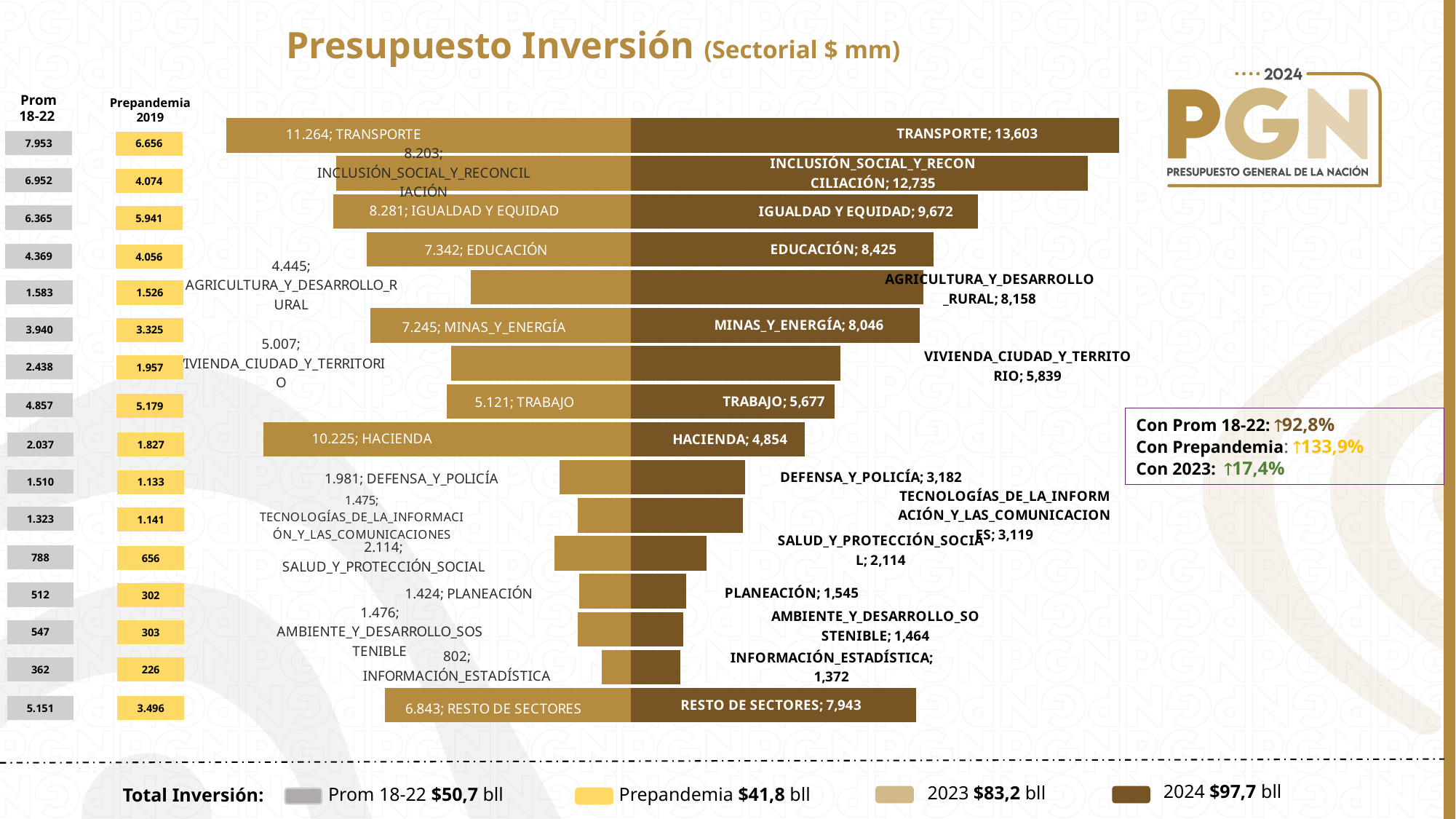
What is the title of the chart? Presupuesto Inversión (Sectorial $ mm) What is the difference between the 2024 and 2023 values for TRANSPORTE? 2,339 Which sector has the highest 2024 value? TRANSPORTE What is the 2024 value for INFORMACIÓN_ESTADÍSTICA? 1,372 What kind of chart is shown on the slide? bar chart In 2024, which is larger: EDUCACIÓN or MINAS_Y_ENERGÍA? EDUCACIÓN Which sector has the lowest 2023 value? INFORMACIÓN_ESTADÍSTICA How many sectors are plotted as bars in the chart? 16 For HACIENDA, which is larger: the 2023 value or the 2024 value? 2023 What is the difference between the 2023 and 2024 values for HACIENDA? 5,371 What is the 2024 value for TRANSPORTE? 13,603 What is the 2023 value for HACIENDA? 10.225